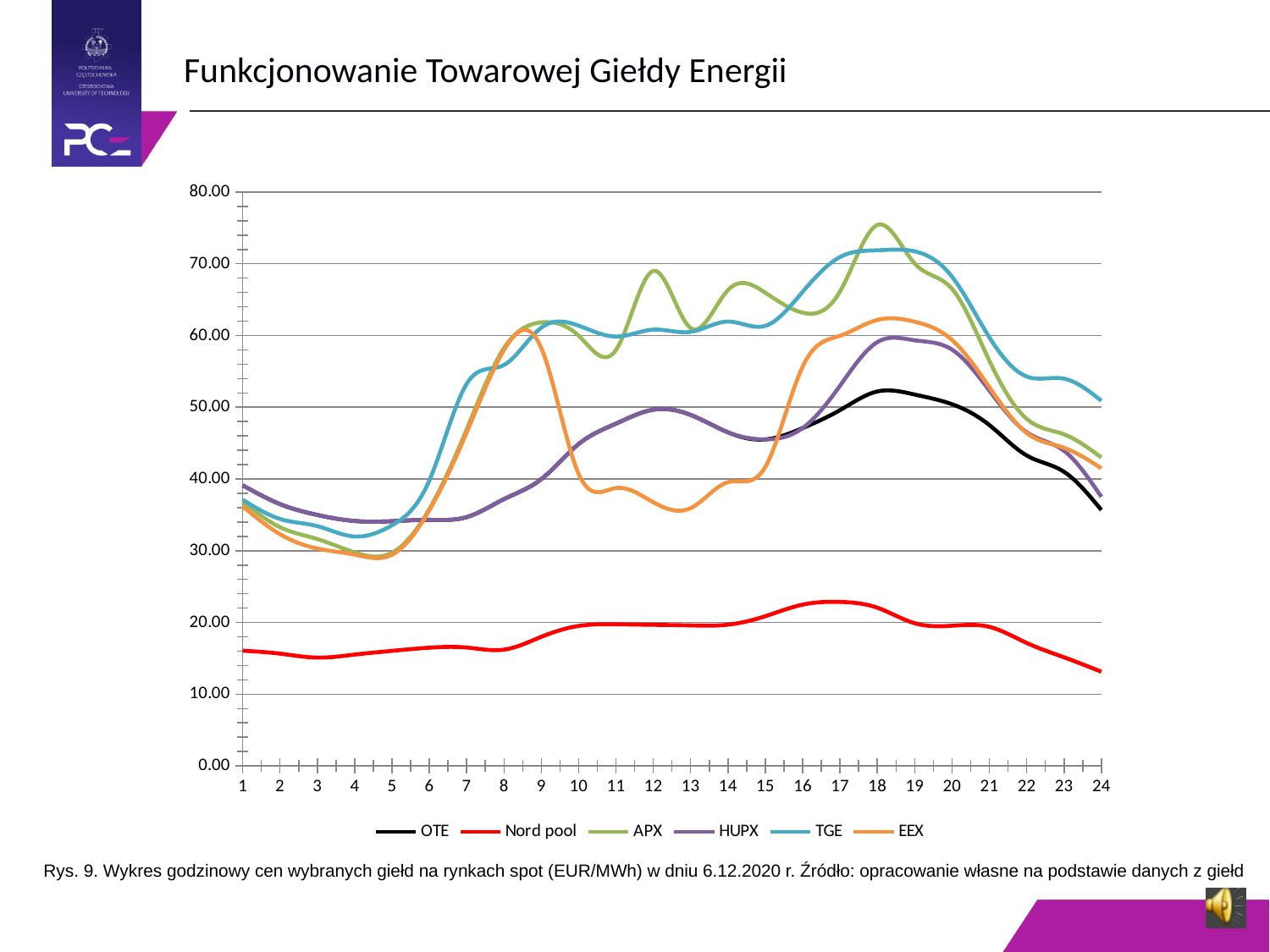
What colour is the Nord pool line in the chart? red Is the value for EEX at hour 13 greater or less than 40.00? less How many series does the legend list? 6 Is the value for APX at hour 18 greater or less than 70.00? greater Which series has the lowest values across the whole chart? Nord pool What kind of chart is shown on the slide? line chart At hour 12, which series has the larger value, APX or HUPX? APX Which series reaches the highest value anywhere on the chart? APX Is the value for OTE at hour 24 greater or less than 40.00? less How many hours (points) are shown along the x axis? 24 Does the Nord pool line rise or fall from hour 18 to hour 24? fall